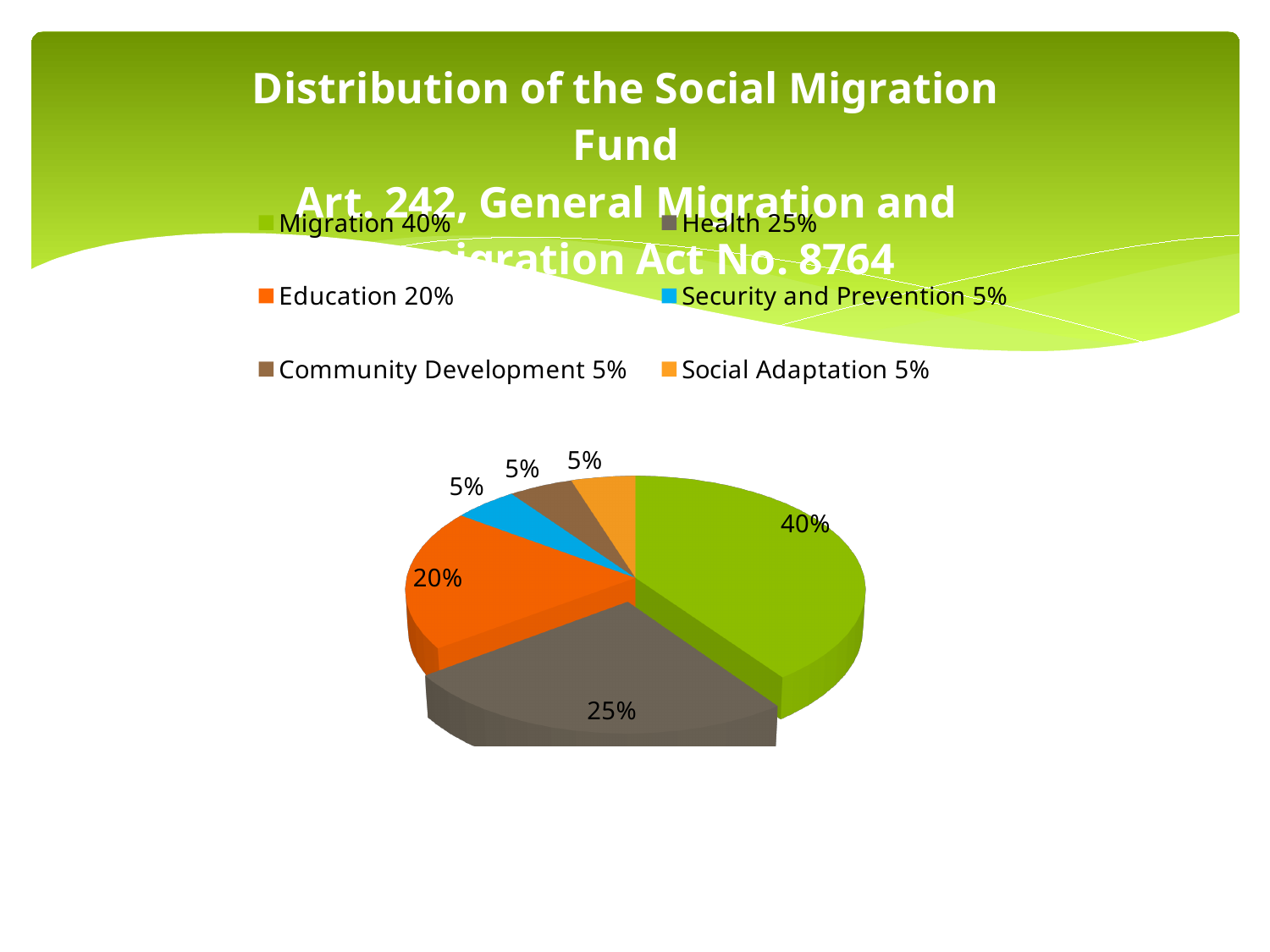
What colour is the Migration slice in the pie chart? green What is the combined share of Community Development and Social Adaptation? 10% Which is larger, the share for Education or the share for Health? Health Which category receives the largest share of the fund? Migration How many entries does the legend list? 6 What share of the fund goes to Security and Prevention? 5% What share of the Social Migration Fund goes to Migration? 40% What is the difference between the Migration share and the Health share? 15% What share of the fund is allocated to Education? 20% How many slices does the pie chart have? 6 What type of chart is shown on the slide? pie chart What share of the fund is allocated to Health? 25%